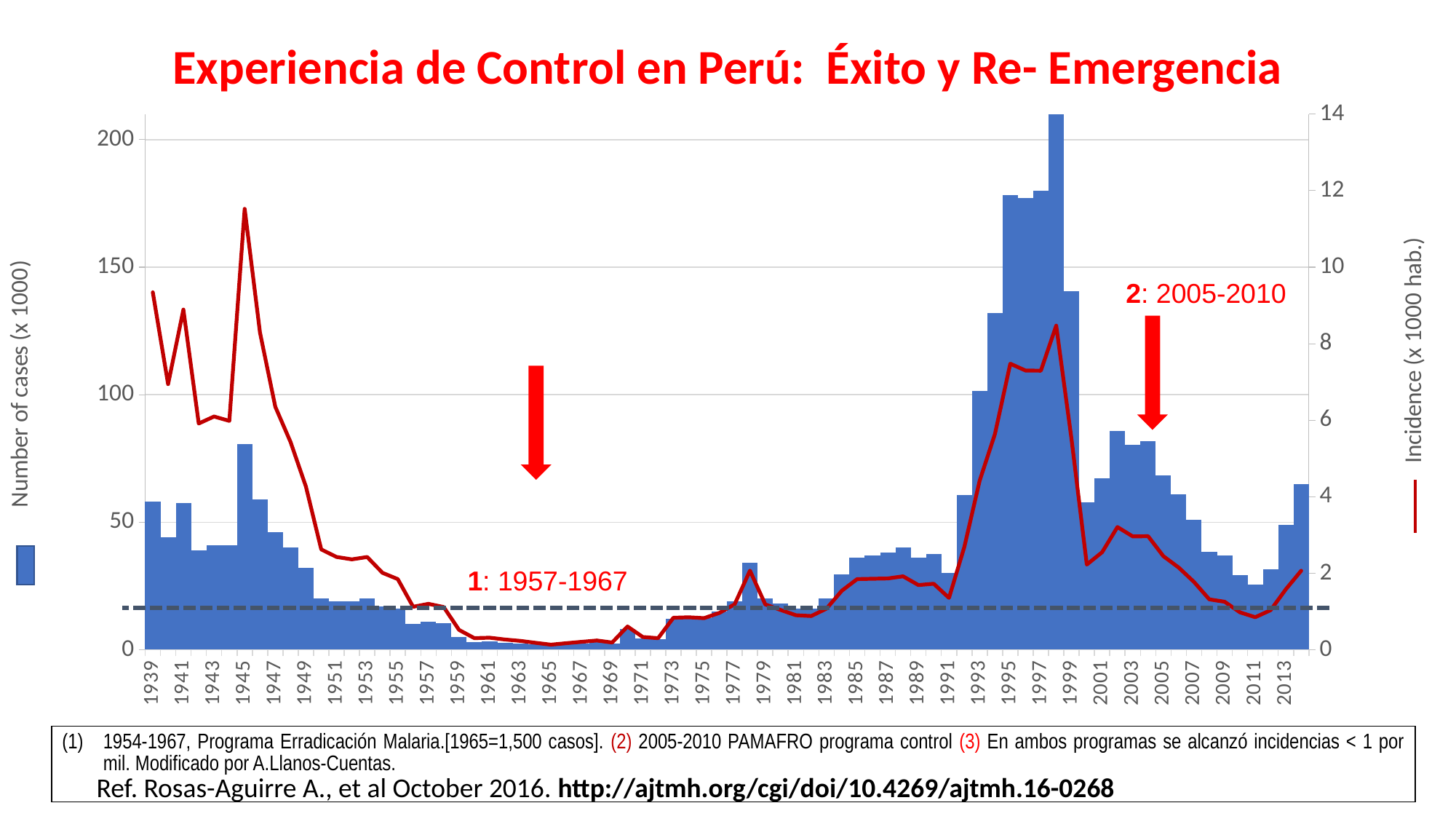
What kind of chart is shown on the slide? A combined bar and line chart Is the number of cases bar for 1998 greater or less than 200? greater Is the number of cases bar for 1965 greater or less than 50? less Which year has the taller number of cases bar, 1945 or 1998? 1998 Do the number of cases bars rise or fall from 1993 to 1998? rise Is the incidence line value for 1945 greater or less than 10? greater What is the title of the chart on the slide? Experiencia de Control en Perú: Éxito y Re- Emergencia In which year do the bars (number of cases) reach their highest value? 1998 What is the label of the left vertical axis? Number of cases (x 1000) In which year does the incidence line reach its highest value? 1945 Which year has the higher incidence line value, 1945 or 1998? 1945